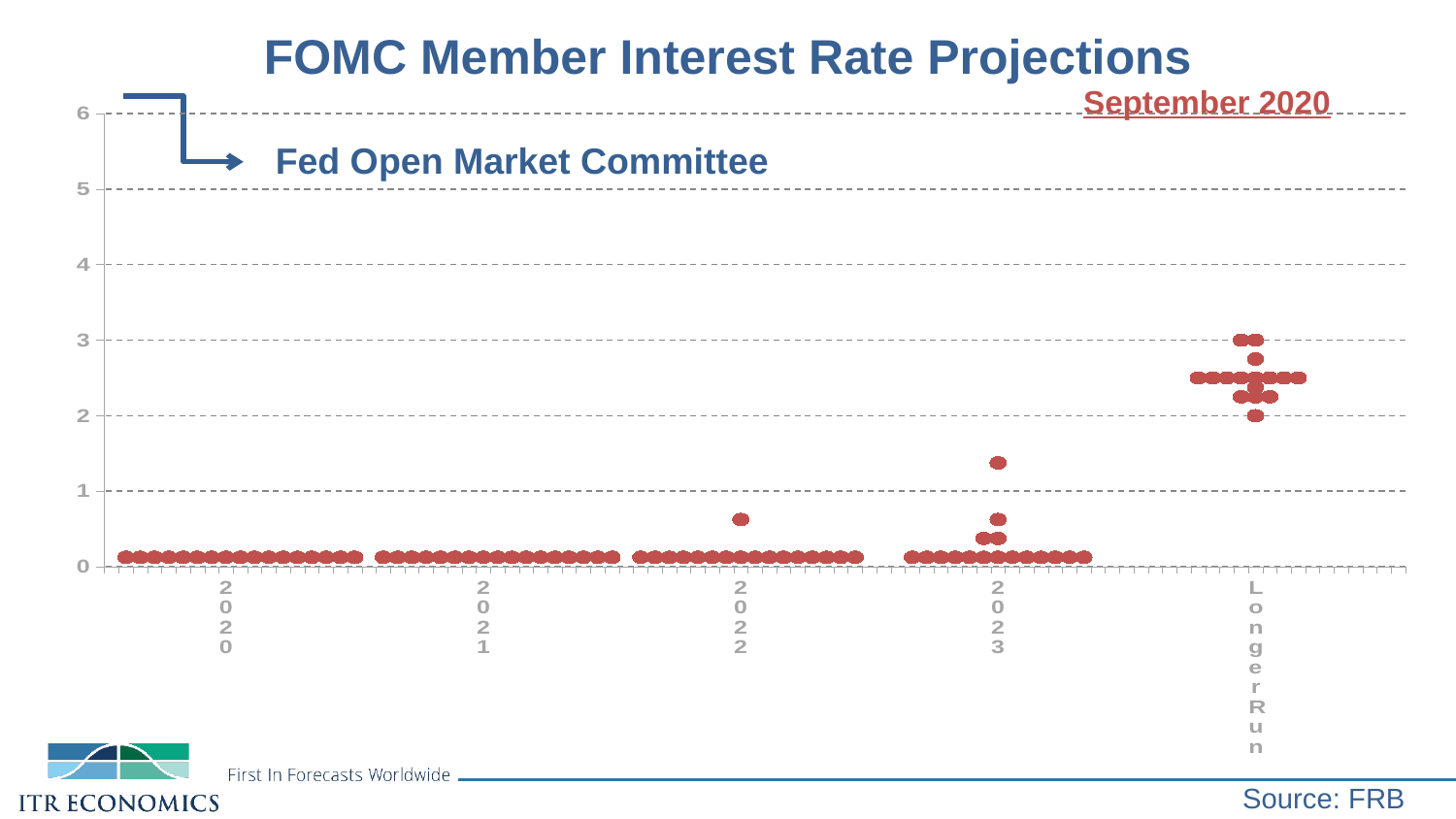
Is the highest projection for 2023 greater or less than 1? greater Which category on the x axis has the highest interest rate projections? Longer Run What is the title of the chart? FOMC Member Interest Rate Projections What kind of chart is shown on the slide? Dot plot (scatter chart) What is the maximum value shown on the y axis? 6 How many categories are shown along the x axis? 5 Are the Longer Run projections greater or less than 4? less Which has higher projections, 2023 or Longer Run? Longer Run Do the projections generally rise or fall moving from 2020 to Longer Run along the x axis? rise Are the projections for 2020 greater or less than 1? less